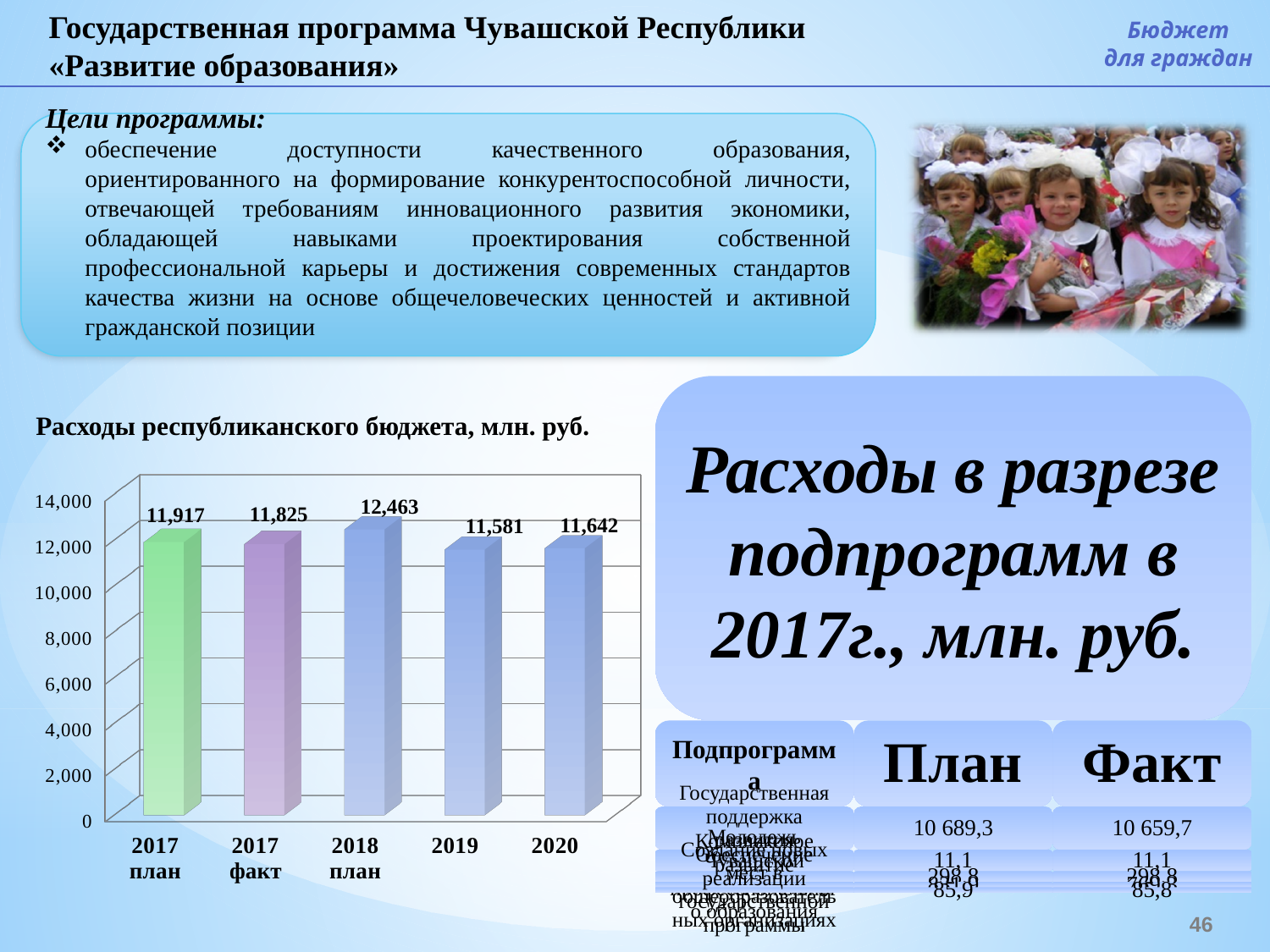
What is the difference between the 2017 план and 2017 факт values in the chart 'Расходы республиканского бюджета, млн. руб.'? 92 How many categories are shown in the chart 'Расходы республиканского бюджета, млн. руб.'? 5 What is the value for 2020 in the chart 'Расходы республиканского бюджета, млн. руб.'? 11,642 What is the title of the chart on the left side of the slide? Расходы республиканского бюджета, млн. руб. Which category has the highest value in the chart 'Расходы республиканского бюджета, млн. руб.'? 2018 план Which category has the lowest value in the chart 'Расходы республиканского бюджета, млн. руб.'? 2019 What is the value for 2018 план in the chart 'Расходы республиканского бюджета, млн. руб.'? 12,463 In the chart 'Расходы республиканского бюджета, млн. руб.', which is larger: the value for 2019 or the value for 2020? 2020 What kind of chart is 'Расходы республиканского бюджета, млн. руб.'? bar chart What is the value for 2017 факт in the chart 'Расходы республиканского бюджета, млн. руб.'? 11,825 Is the value for 2018 план in the chart 'Расходы республиканского бюджета, млн. руб.' greater or less than 12,000? greater What is the difference between the 2018 план and 2019 values in the chart 'Расходы республиканского бюджета, млн. руб.'? 882